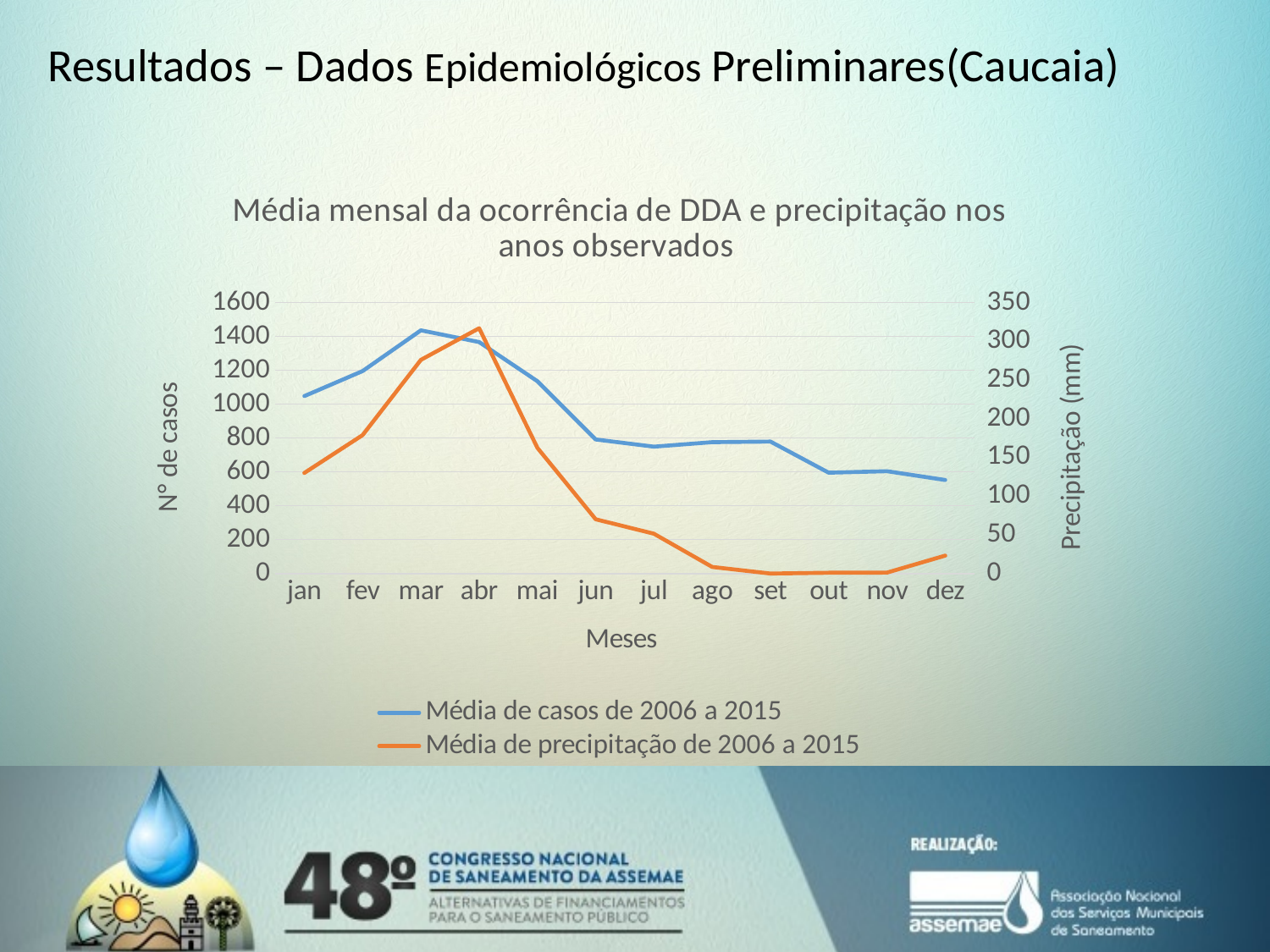
How many series does the legend list? 2 Is the value of 'Média de casos de 2006 a 2015' for jan greater or less than 1000? greater What kind of chart is shown on the slide? Line chart What is the label of the right-hand vertical axis? Precipitação (mm) How many months are plotted along the x axis? 12 Is the value of 'Média de precipitação de 2006 a 2015' for ago greater or less than 50? less In which month does the 'Média de casos de 2006 a 2015' line reach its highest value? mar In which month does the 'Média de precipitação de 2006 a 2015' line reach its highest value? abr Is the value of 'Média de casos de 2006 a 2015' for jun greater or less than 1000? less Which month has the larger value for 'Média de precipitação de 2006 a 2015', jan or jun? jan In which month is the 'Média de casos de 2006 a 2015' line at its lowest value? dez